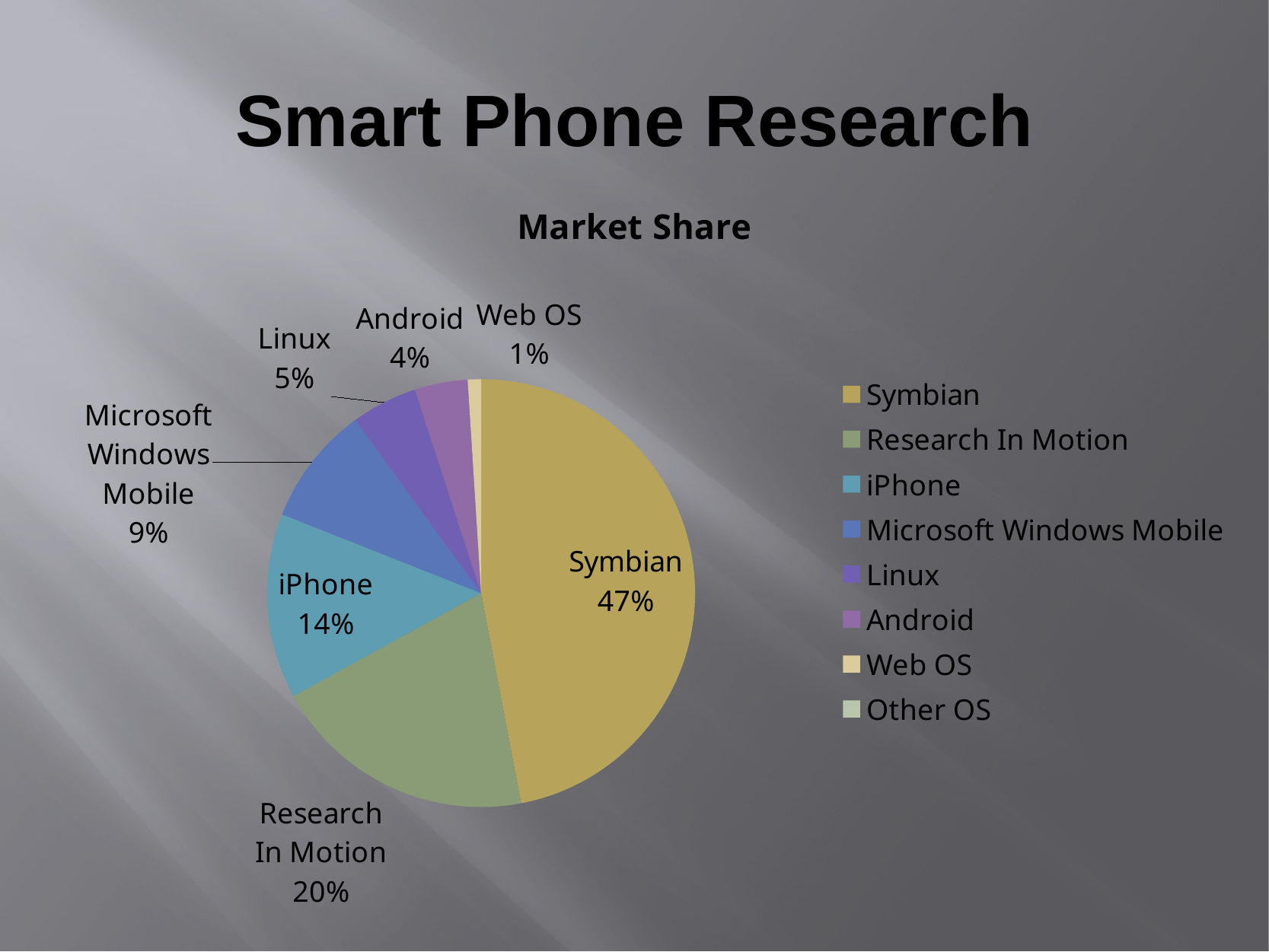
What percentage is shown for iPhone? 14% What is the title of the chart? Market Share What share of the pie does Symbian hold? 47% What percentage is shown for Microsoft Windows Mobile? 9% Which slice with a printed percentage is the smallest? Web OS How many percentage points larger is Symbian's share than Research In Motion's? 27 What type of chart is shown on the slide? pie chart What percentage is shown for Android? 4% Which has the larger share, iPhone or Microsoft Windows Mobile? iPhone Which category has the largest slice of the pie? Symbian What percentage is shown for Research In Motion? 20% How many entries does the legend list? 8